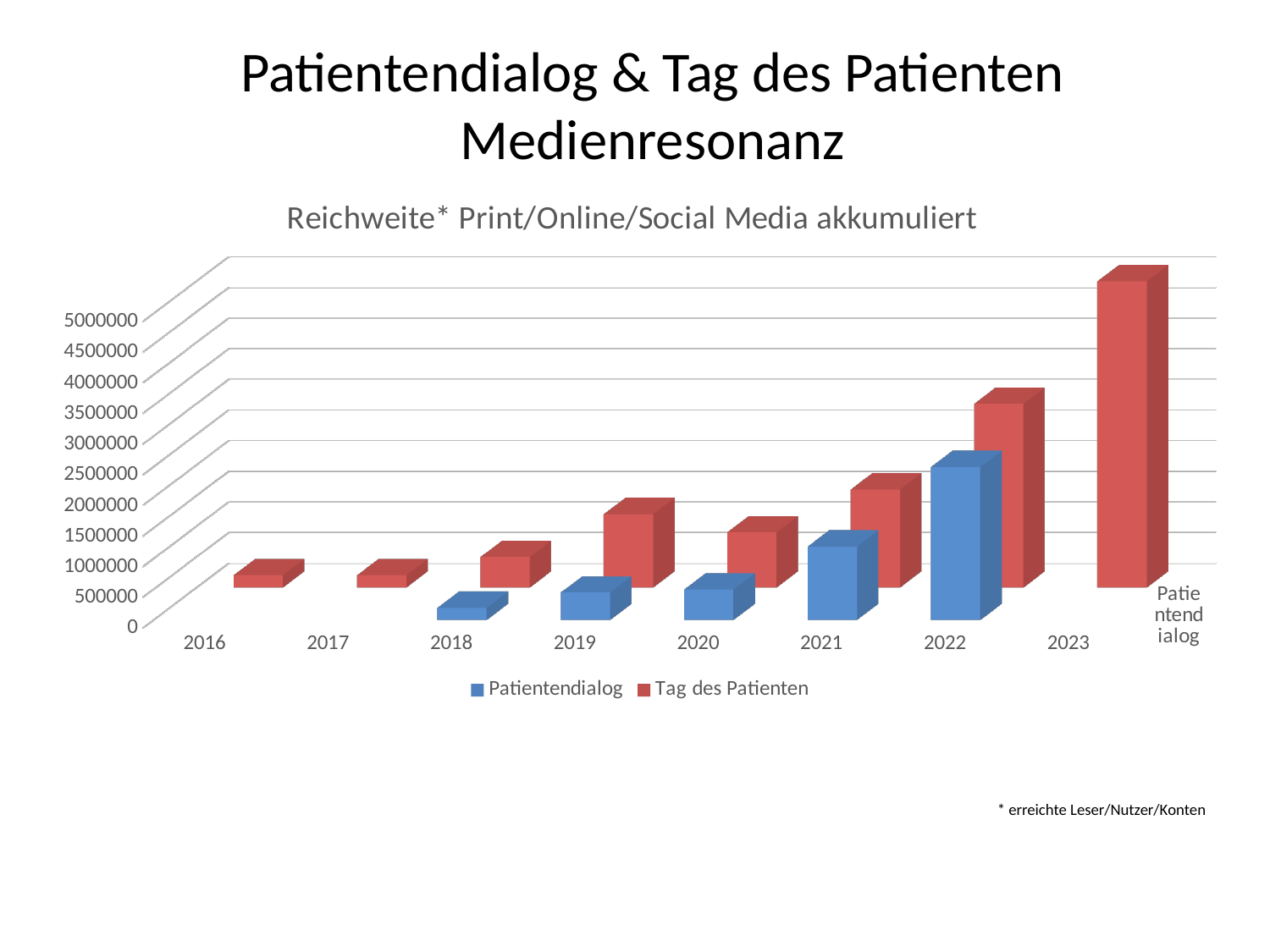
Do the Patientendialog values rise or fall from 2018 to 2022? rise In which year is the Tag des Patienten bar the highest? 2023 Which is larger, Tag des Patienten in 2019 or Tag des Patienten in 2020? 2019 How many years are shown on the x axis? 8 In which year is the Patientendialog bar the highest? 2022 Is the value for Tag des Patienten in 2016 greater or less than 1500000? less Is the value for Patientendialog in 2022 greater or less than 1500000? greater What is the title of the chart? Reichweite* Print/Online/Social Media akkumuliert Is the value for Tag des Patienten in 2023 greater or less than 4000000? greater In 2022, which series has the larger value, Patientendialog or Tag des Patienten? Tag des Patienten What kind of chart is shown on the slide? bar chart How many series does the legend list? 2